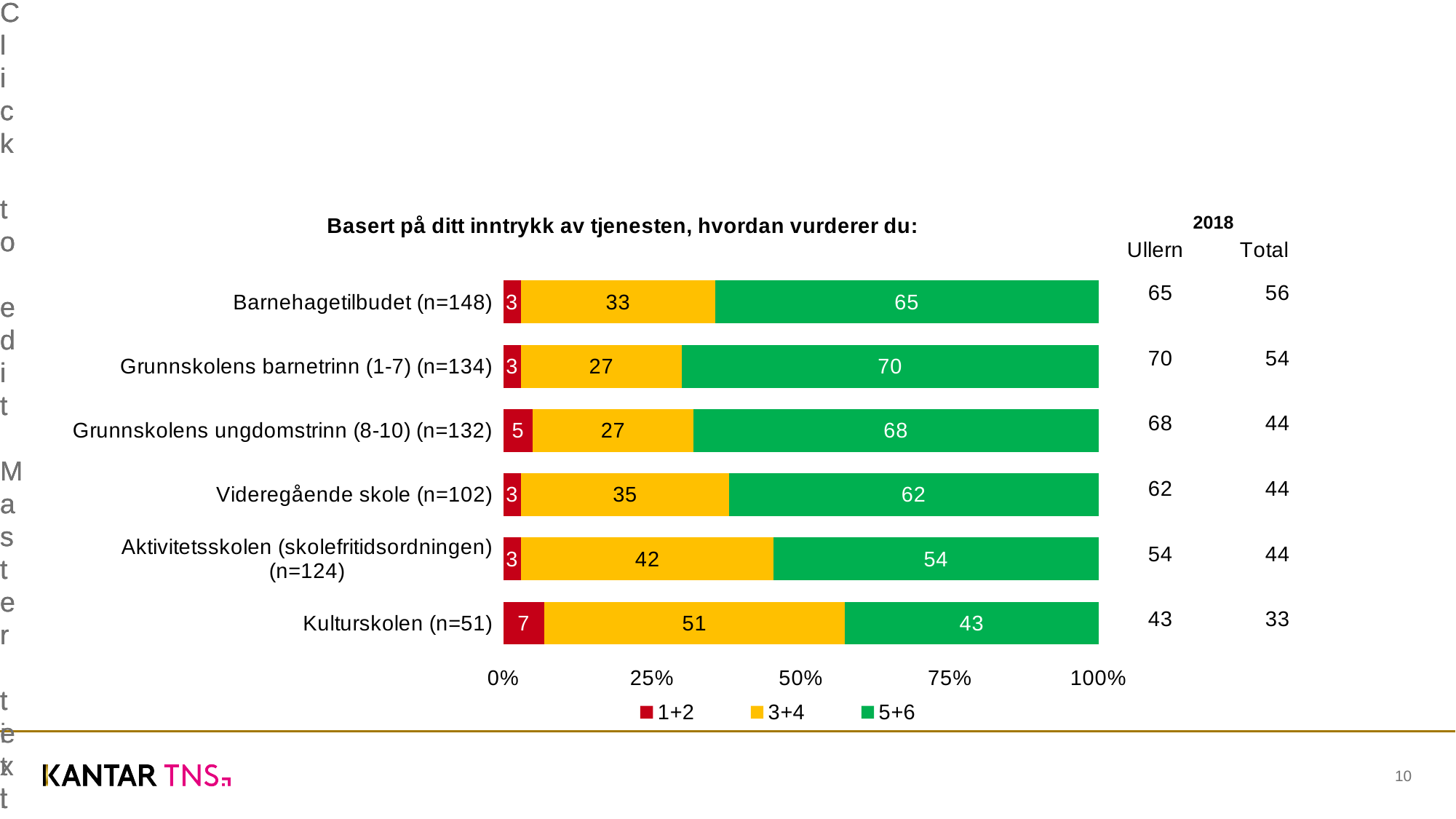
Which category has the highest 1+2 value? Kulturskolen (n=51) What kind of chart is shown on the slide? Stacked bar chart How many categories are shown in the chart? 6 Which is larger: the 3+4 value for Aktivitetsskolen (skolefritidsordningen) (n=124) or for Videregående skole (n=102)? Aktivitetsskolen (skolefritidsordningen) (n=124) Which category has the lowest 5+6 value? Kulturskolen (n=51) What is the title of the chart? Basert på ditt inntrykk av tjenesten, hvordan vurderer du: Which category has the highest 5+6 value? Grunnskolens barnetrinn (1-7) (n=134) What is the difference between the 5+6 values for Barnehagetilbudet (n=148) and Kulturskolen (n=51)? 22 What is the 3+4 value for Kulturskolen (n=51)? 51 What is the 1+2 value for Grunnskolens ungdomstrinn (8-10) (n=132)? 5 How many series does the legend list? 3 What is the 5+6 value for Grunnskolens barnetrinn (1-7) (n=134)? 70